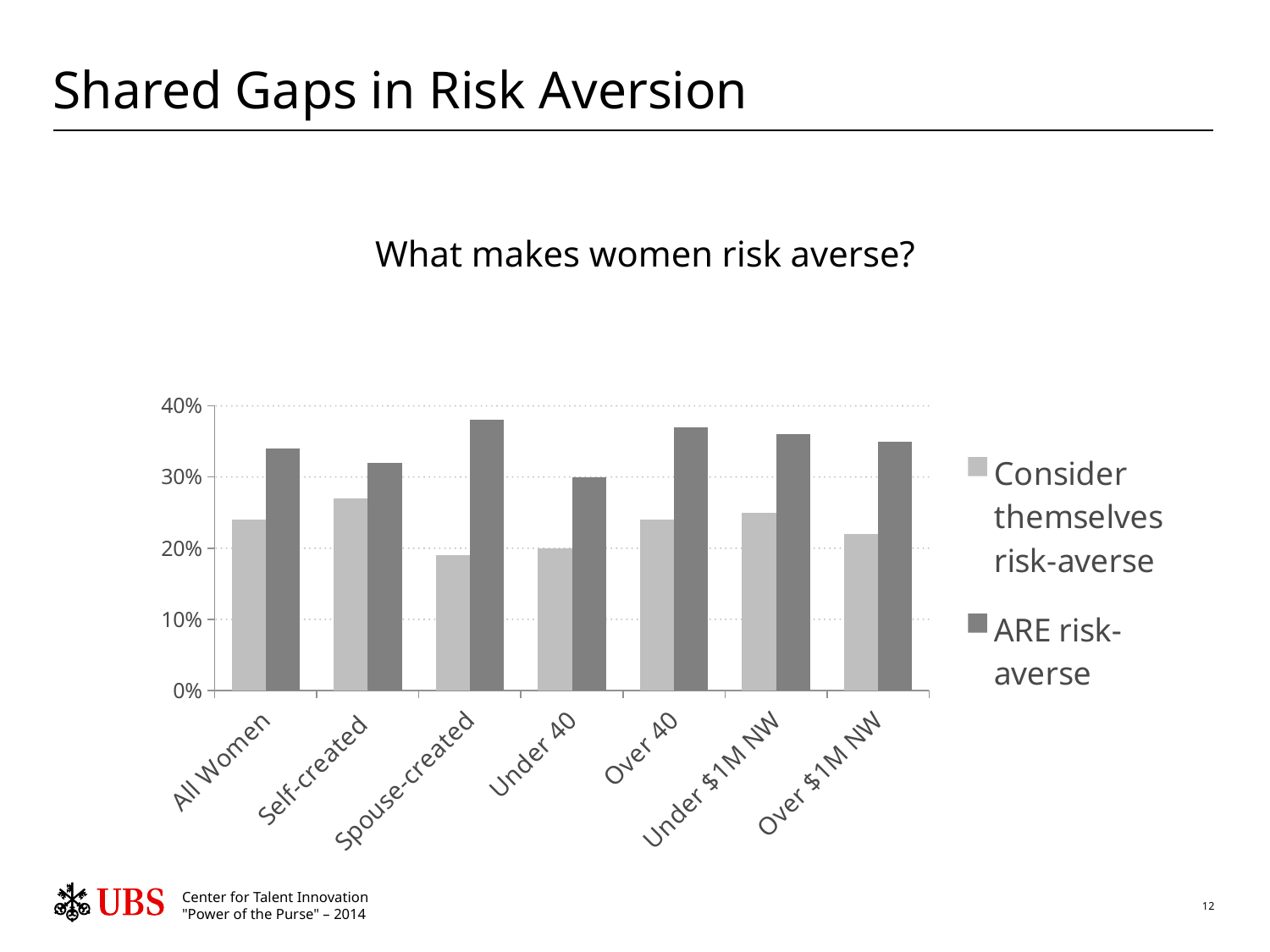
Which has the larger 'ARE risk-averse' value: Spouse-created or Under 40? Spouse-created How many series does the legend list? 2 What kind of chart is shown on the slide? bar chart For Under 40, which is larger: the 'Consider themselves risk-averse' value or the 'ARE risk-averse' value? ARE risk-averse Which series is shown in the darker grey bars? ARE risk-averse Is the 'ARE risk-averse' value for Spouse-created greater or less than 30%? greater What is the title of the chart? What makes women risk averse? Is the 'ARE risk-averse' value for Over 40 greater or less than 30%? greater How many categories are shown on the x axis of the chart? 7 Is the 'Consider themselves risk-averse' value for Self-created greater or less than 20%? greater Which category has the lowest 'ARE risk-averse' value? Under 40